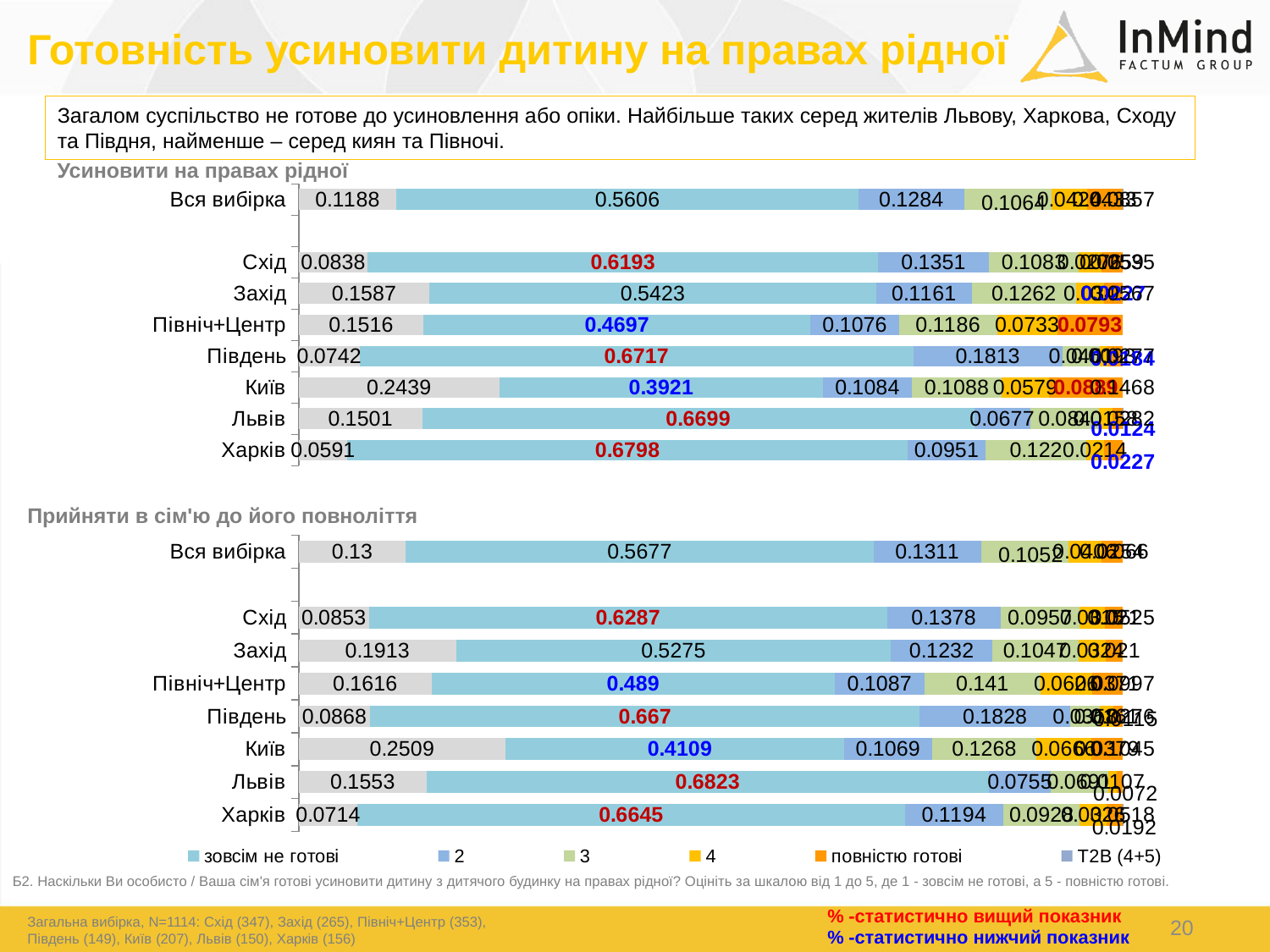
In the 'Прийняти в сім'ю до його повноліття' chart, what is the 'зовсім не готові' value for Львів? 0.6823 What kind of chart is used for 'Усиновити на правах рідної'? bar chart How many series does the legend at the bottom of the slide list? 6 In the 'Усиновити на правах рідної' chart, which category has the highest 'зовсім не готові' value? Харків In the 'Прийняти в сім'ю до його повноліття' chart, which has the larger 'зовсім не готові' value, Схід or Захід? Схід In the 'Усиновити на правах рідної' chart, what is the 'зовсім не готові' value for Вся вибірка? 0.5606 In the 'Усиновити на правах рідної' chart, what is the difference between the 'зовсім не готові' values for Харків and Київ? 0.2877 In the 'Усиновити на правах рідної' chart, what is the 'зовсім не готові' value for Київ? 0.3921 How many categories (rows) does the 'Усиновити на правах рідної' chart show? 8 In the 'Усиновити на правах рідної' chart, which category has the lowest 'зовсім не готові' value? Київ In the 'Усиновити на правах рідної' chart, what is the value of series '2' for Південь? 0.1813 In the 'Прийняти в сім'ю до його повноліття' chart, which category has the highest 'зовсім не готові' value? Львів